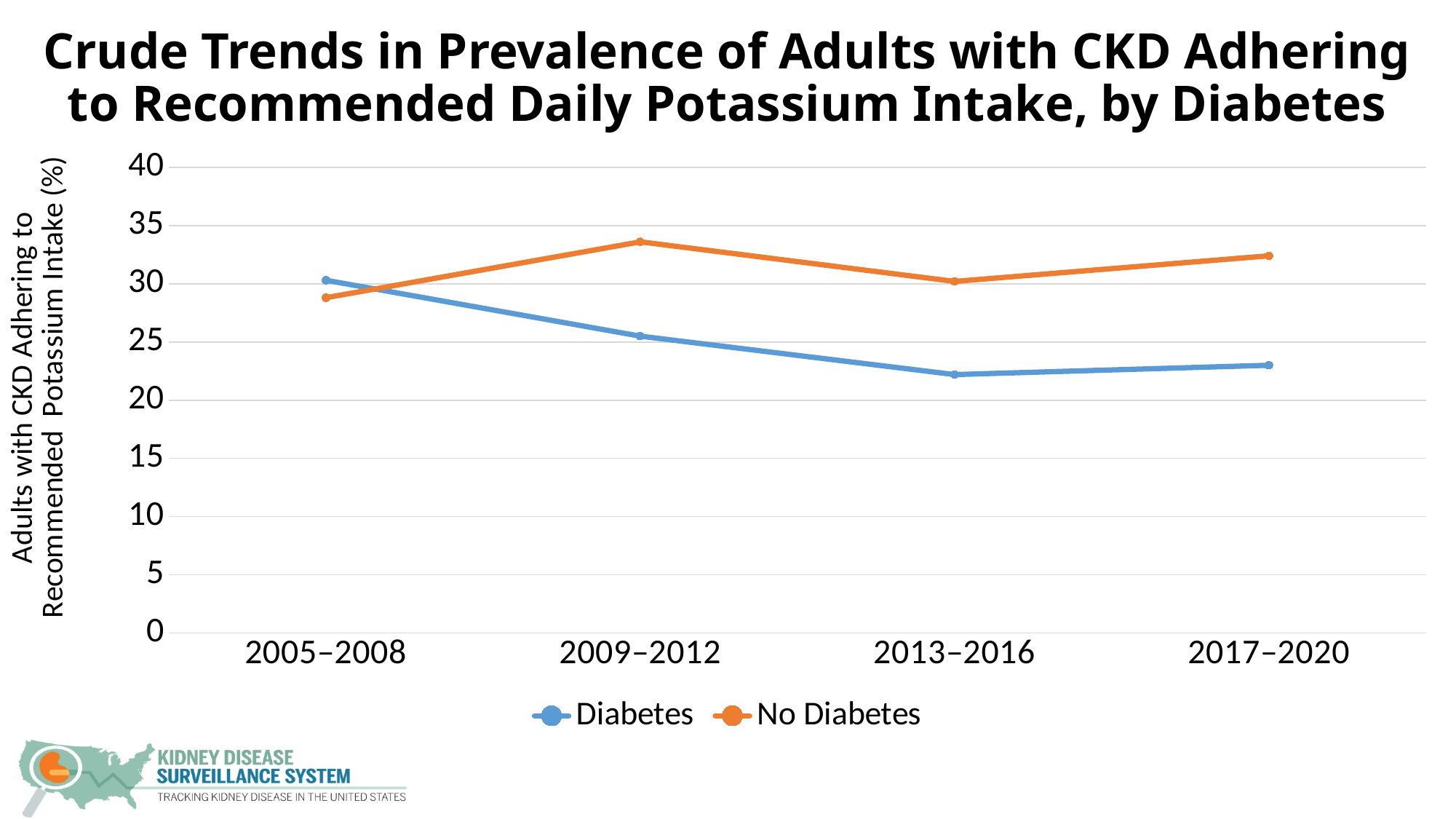
In which time period is the No Diabetes series at its highest? 2009–2012 In 2005–2008, which series has the higher value, Diabetes or No Diabetes? Diabetes Is the value for No Diabetes in 2005–2008 greater or less than 30? less Is the value for No Diabetes in 2009–2012 greater or less than 30? greater Is the value for Diabetes in 2005–2008 greater or less than 25? greater Does the Diabetes series rise or fall from 2005–2008 to 2013–2016? fall What kind of chart is shown on the slide? line chart How many series does the legend list? 2 How many time periods are shown on the x axis? 4 In which time period is the Diabetes series at its lowest? 2013–2016 In 2017–2020, which series has the higher value, Diabetes or No Diabetes? No Diabetes